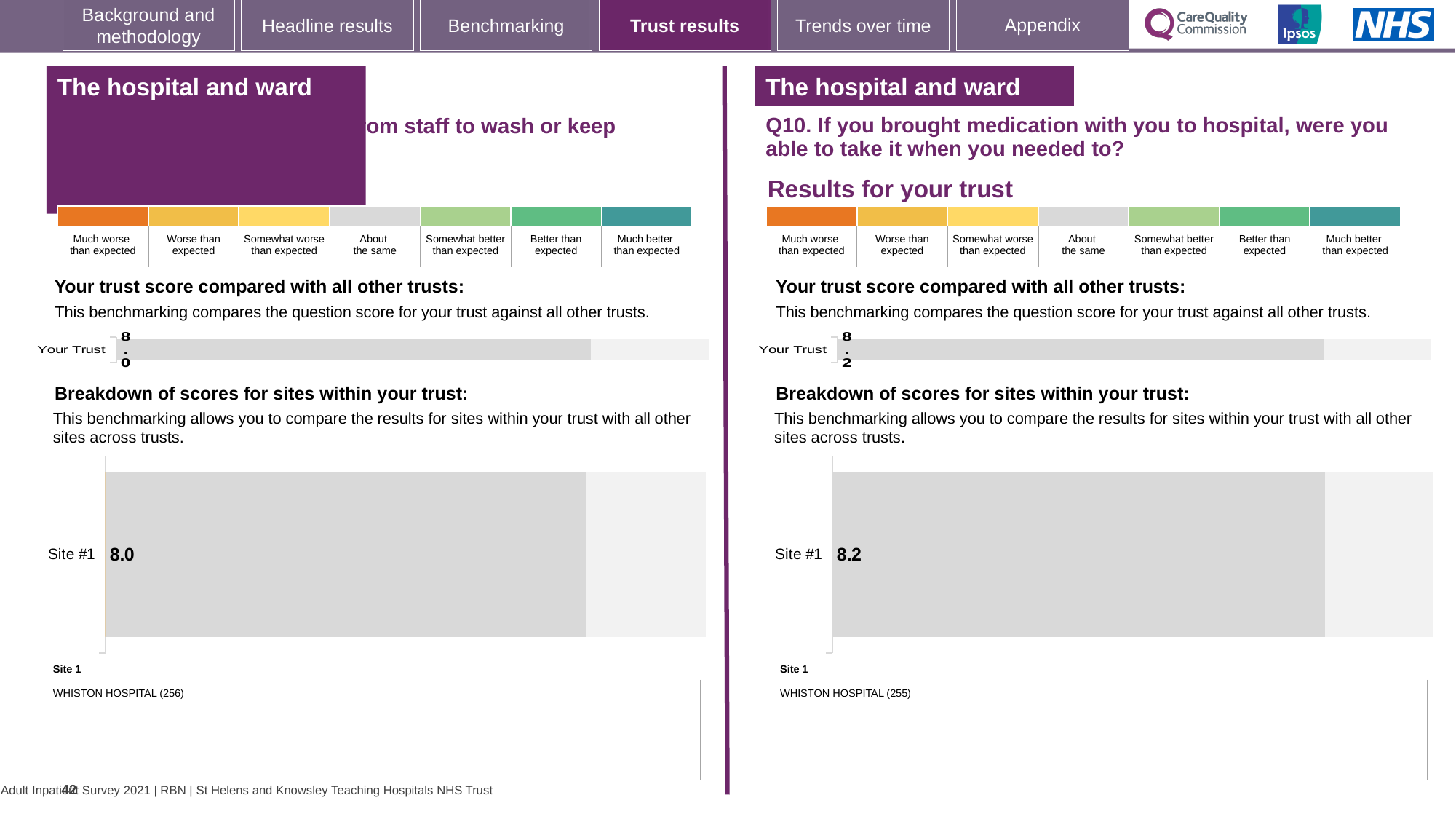
Which is larger: the Site #1 score in the left-hand breakdown chart or the Site #1 score in the right-hand breakdown chart (Q10)? The right-hand chart (Q10) How many sites are shown in the left-hand 'Breakdown of scores for sites within your trust' chart? 1 Which hospital is listed as Site 1 below the right-hand breakdown chart (Q10)? WHISTON HOSPITAL (255) On the left-hand side of the slide, what is the score shown for Your Trust? 8.0 On the right-hand side of the slide (Q10, about taking medication brought to hospital), what is the score shown for Your Trust? 8.2 What is the difference between the Your Trust score on the right-hand side (Q10) and the Your Trust score on the left-hand side? 0.2 Which hospital is listed as Site 1 below the left-hand breakdown chart? WHISTON HOSPITAL (256) How many sites are shown in the right-hand 'Breakdown of scores for sites within your trust' chart (Q10)? 1 In the right-hand 'Breakdown of scores for sites within your trust' chart (Q10), what is the score for Site #1? 8.2 What type of chart is used to show the Site #1 score in the right-hand breakdown (Q10)? Bar chart In the left-hand 'Breakdown of scores for sites within your trust' chart, what is the score for Site #1? 8.0